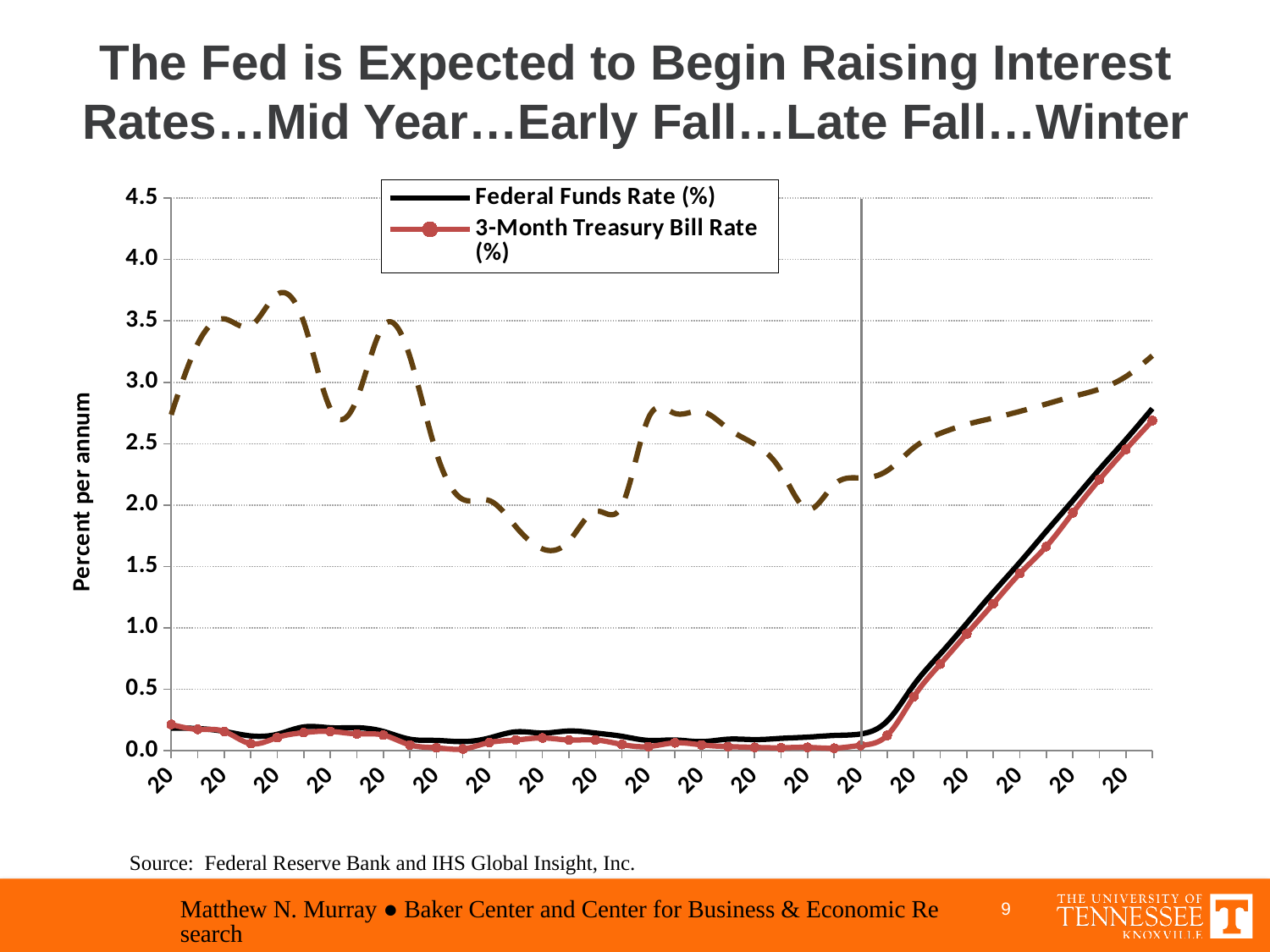
Is the Federal Funds Rate at the far left end of the chart greater or less than 0.5? less What are the two series named in the legend? Federal Funds Rate (%) and 3-Month Treasury Bill Rate (%) What is the label on the vertical axis of the chart? Percent per annum How many series does the chart's legend list? 2 What is the highest value shown on the vertical axis? 4.5 Is the peak of the dashed line near the left of the chart greater or less than 3.5? greater At the far right end of the chart, which is higher: the dashed line or the Federal Funds Rate? The dashed line Does the Federal Funds Rate rise or fall along the x axis after the vertical line on the right side of the chart? Rise Is the 3-Month Treasury Bill Rate at the point where the vertical line crosses the chart greater or less than 0.5? less What kind of chart is shown on the slide? Line chart